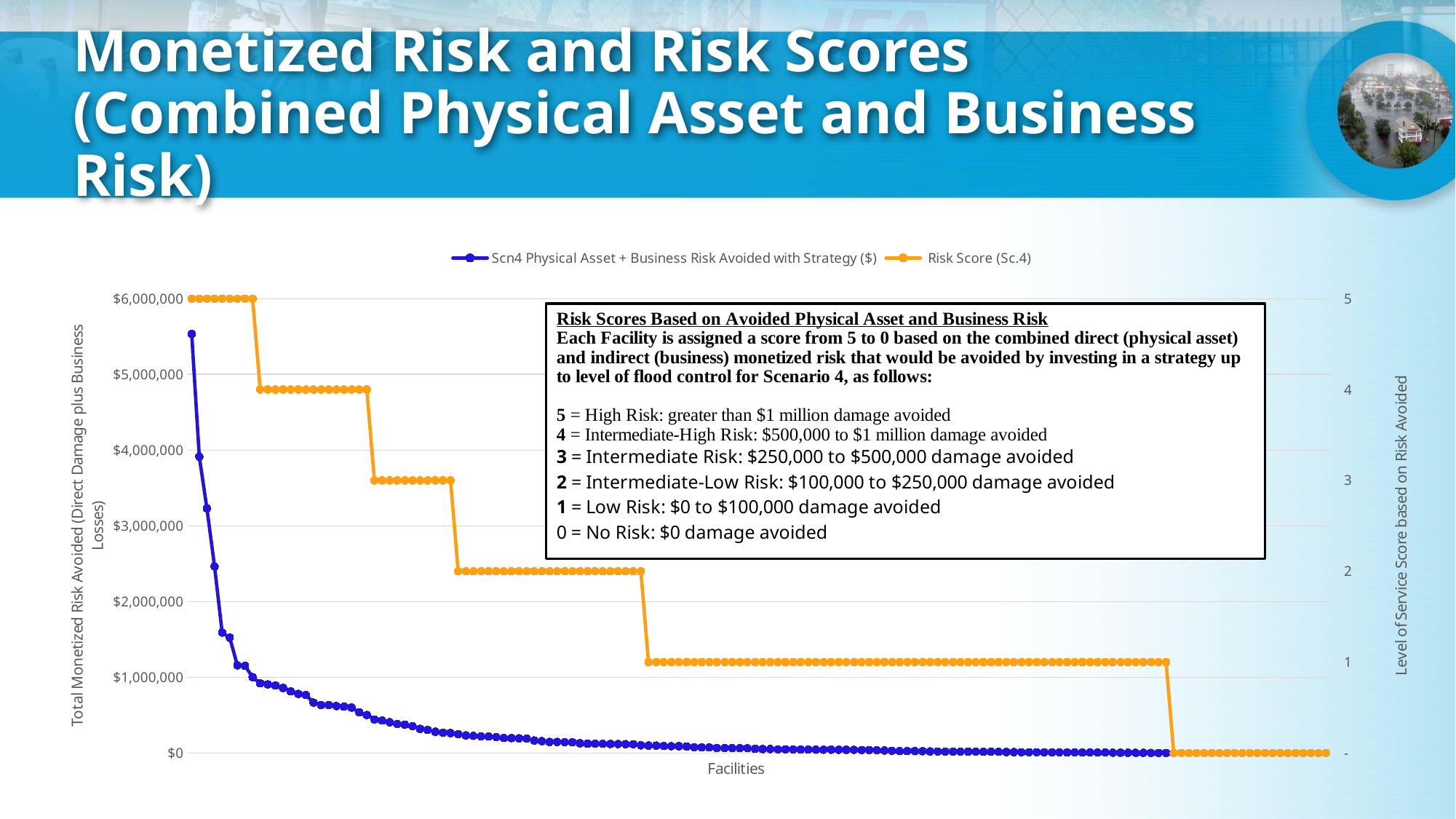
What is the highest value shown on the right vertical axis? 5 What kind of chart is shown on the slide? Line chart What is the name of the series plotted in orange? Risk Score (Sc.4) What is the name of the series plotted in blue? Scn4 Physical Asset + Business Risk Avoided with Strategy ($) Is the first (leftmost) value of the blue series greater or less than $5,000,000? greater What is the label of the horizontal axis? Facilities What is the highest Risk Score (Sc.4) value plotted on the chart? 5 What is the highest value shown on the left vertical axis? $6,000,000 How many series does the chart legend list? 2 Is the first (leftmost) value of the blue series greater or less than $6,000,000? less Do the values of the Risk Score (Sc.4) series rise or fall from left to right along the x axis? Fall Do the values of the blue series rise or fall from left to right along the x axis? Fall